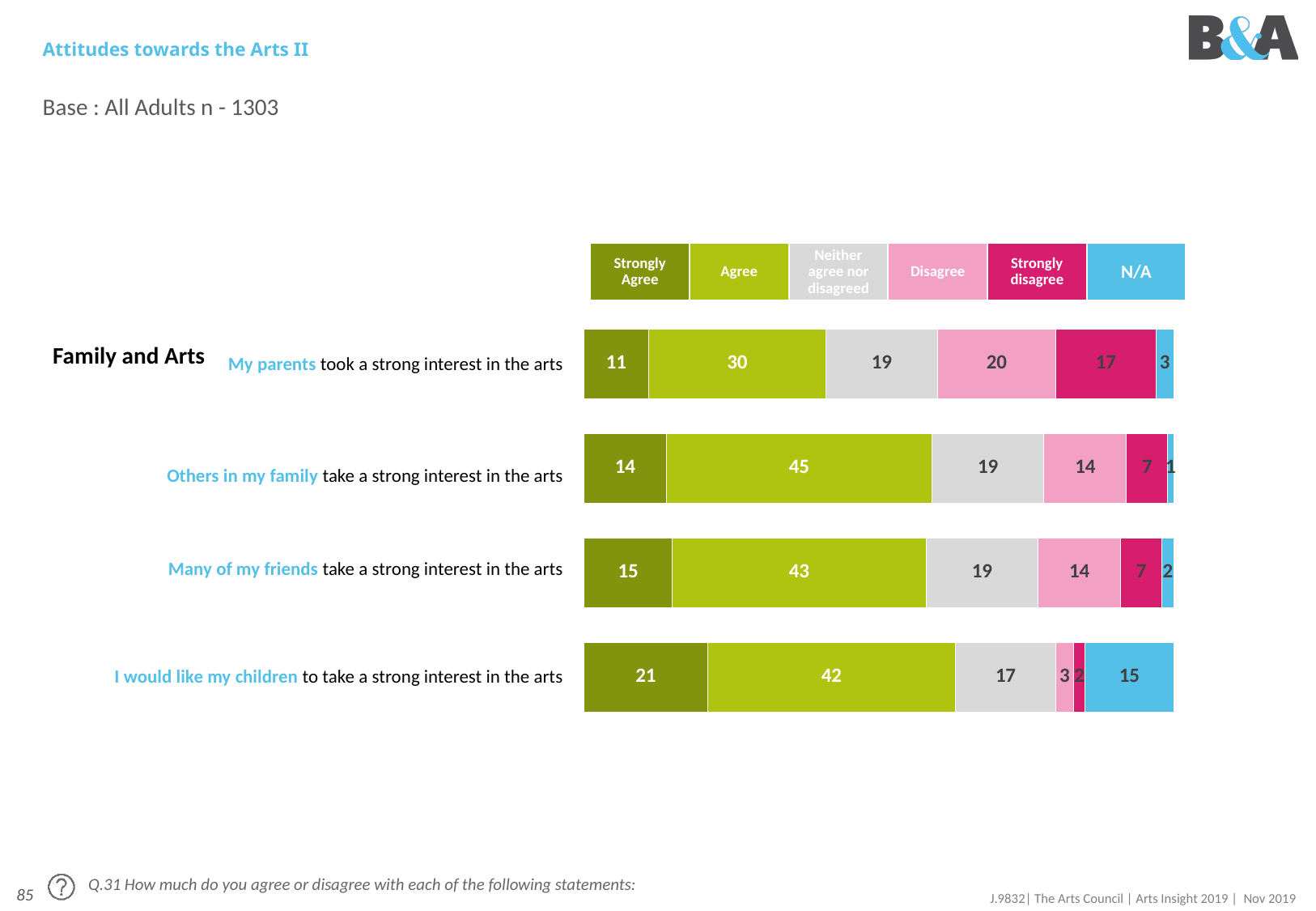
Which is larger: the 'Strongly Agree' value for 'Many of my friends' or for 'Others in my family'? Many of my friends What is the 'Disagree' value for 'Many of my friends take a strong interest in the arts'? 14 What is the total of the stacked bar for 'My parents took a strong interest in the arts'? 100 Which statement has the highest 'Strongly Agree' value? I would like my children to take a strong interest in the arts How many statements are shown in the chart? 4 What is the 'N/A' value for 'I would like my children to take a strong interest in the arts'? 15 What is the 'Agree' value for 'Others in my family take a strong interest in the arts'? 45 What is the difference between the 'Agree' values for 'Others in my family' and 'My parents'? 15 What kind of chart is shown on the slide? Stacked bar chart What is the 'Strongly disagree' value for 'My parents took a strong interest in the arts'? 17 How many series does the legend list? 6 Which statement has the lowest 'Agree' value? My parents took a strong interest in the arts